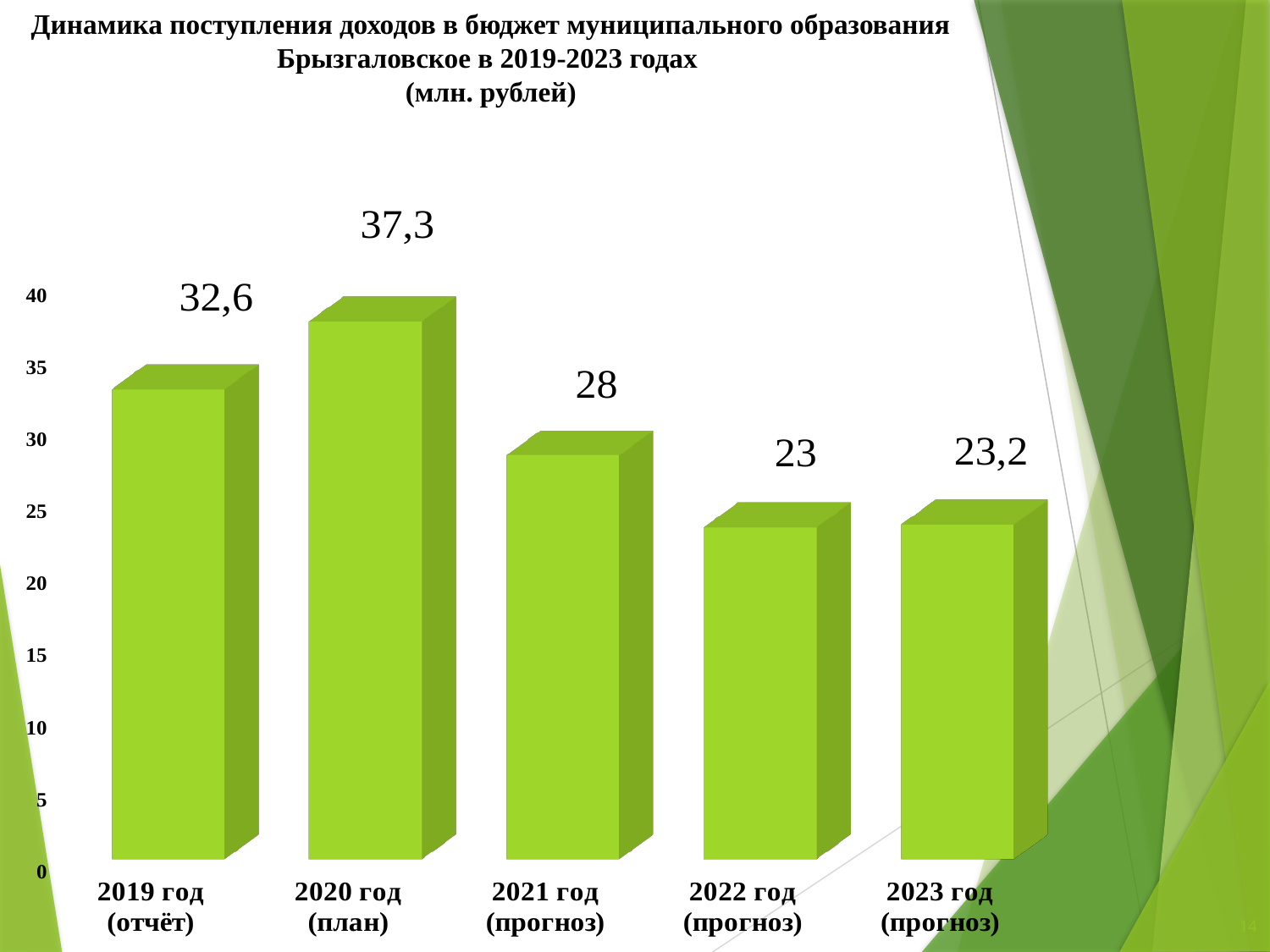
What is the value for 2023 год (прогноз)? 23,2 How many years are shown on the chart? 5 Which year has the highest value? 2020 год (план) What is the value for 2020 год (план)? 37,3 What is the difference between the values for 2021 год (прогноз) and 2022 год (прогноз)? 5 What is the difference between the values for 2020 год (план) and 2019 год (отчёт)? 4,7 Is the value for 2021 год (прогноз) greater or less than 25? greater Which year has the lowest value? 2022 год (прогноз) Do the values rise or fall from 2020 год (план) to 2022 год (прогноз)? fall What is the value for 2021 год (прогноз)? 28 What kind of chart is shown on the slide? bar chart Which is larger, the value for 2019 год (отчёт) or 2021 год (прогноз)? 2019 год (отчёт)